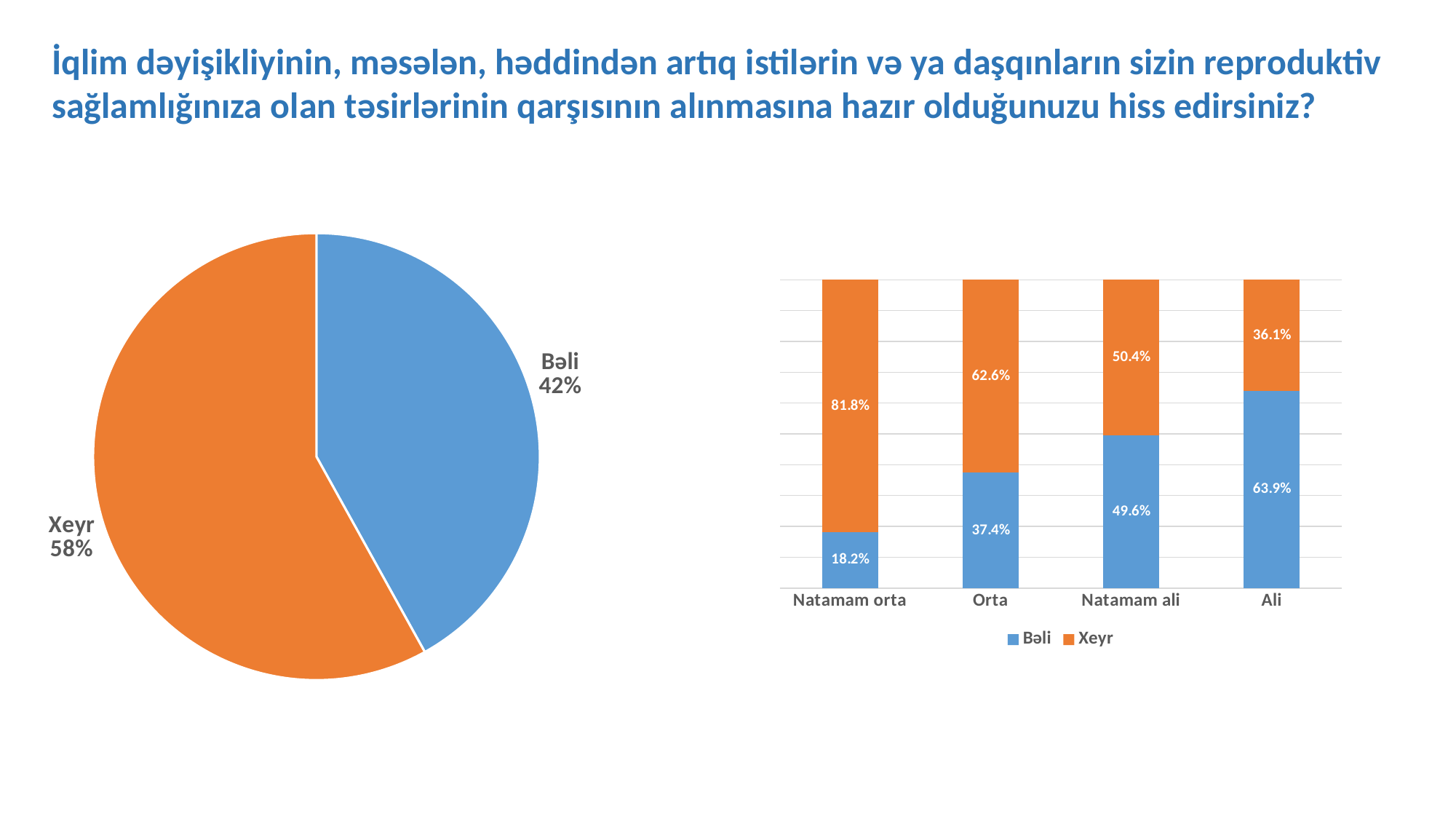
In the stacked bar chart on the right, which category has the highest Bəli value? Ali In the stacked bar chart on the right, does the Bəli value rise or fall from Natamam orta to Ali? rise In the pie chart on the left, what share is labelled for Xeyr? 58% In the stacked bar chart on the right, which category has the lowest Xeyr value? Ali In the pie chart on the left, what share is labelled for Bəli? 42% In the stacked bar chart on the right, what is the Bəli value for Natamam orta? 18.2% In the stacked bar chart on the right, what is the difference between the Xeyr values for Natamam orta and Ali? 45.7% In the pie chart on the left, how many slices are there? 2 In the stacked bar chart on the right, how many series does the legend list? 2 In the pie chart on the left, which slice is larger, Bəli or Xeyr? Xeyr In the stacked bar chart on the right, what is the Xeyr value for Orta? 62.6% In the stacked bar chart on the right, what is the Bəli value for Ali? 63.9%